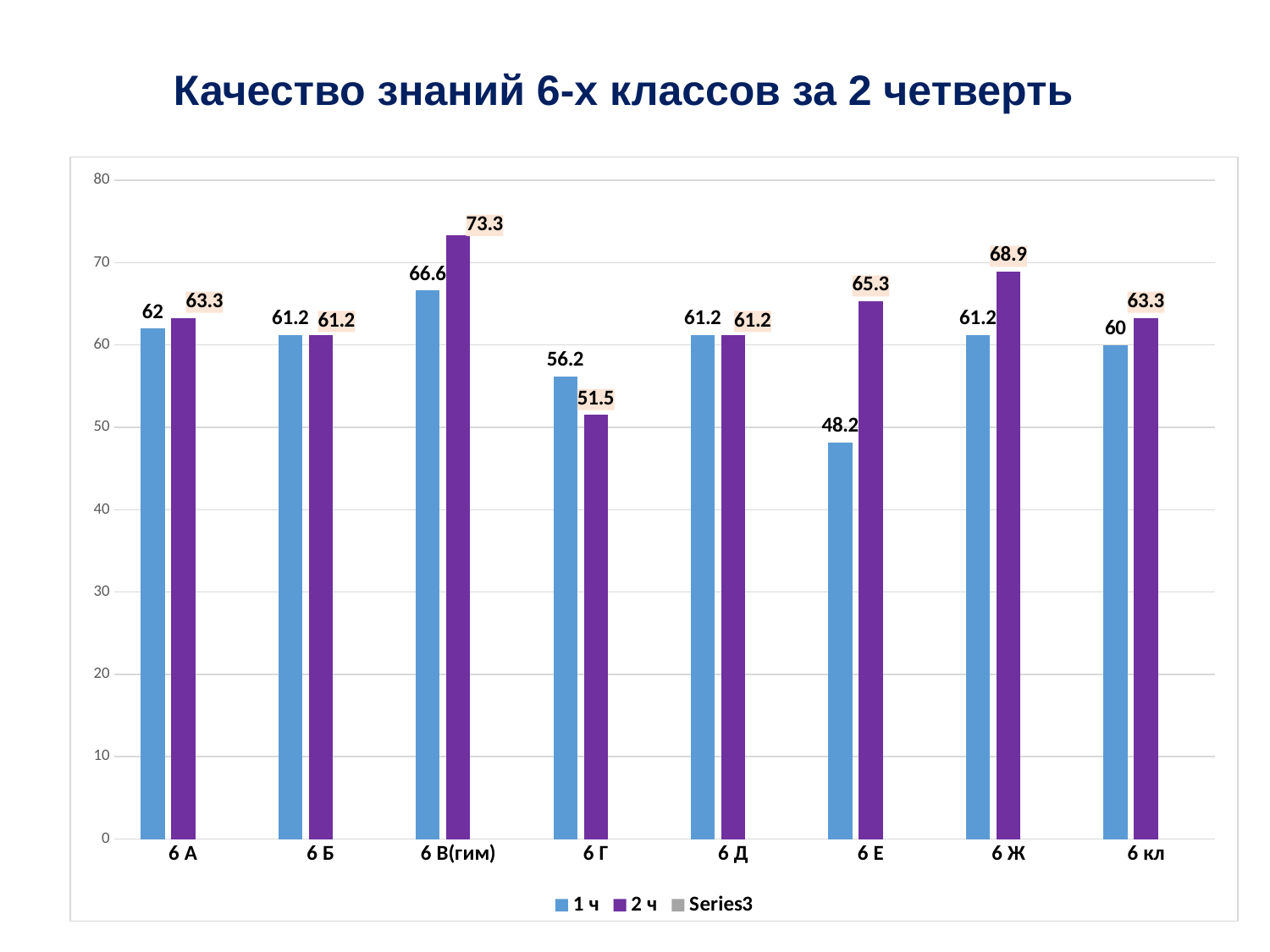
What is the value for 6 кл in the 1 ч series? 60 What kind of chart is shown on the slide? bar chart What is the difference between the 1 ч and 2 ч values for 6 Г? 4.7 Which category has the lowest value in the 1 ч series? 6 Е Which is larger for 6 Ж: the 1 ч value or the 2 ч value? 2 ч How many categories are shown on the x axis? 8 What is the title of the slide? Качество знаний 6-х классов за 2 четверть What is the value for 6 Е in the 1 ч series? 48.2 What is the value for 6 В(гим) in the 2 ч series? 73.3 How many series does the legend list? 3 Which category has the highest value in the 2 ч series? 6 В(гим) What is the difference between the 2 ч and 1 ч values for 6 Е? 17.1